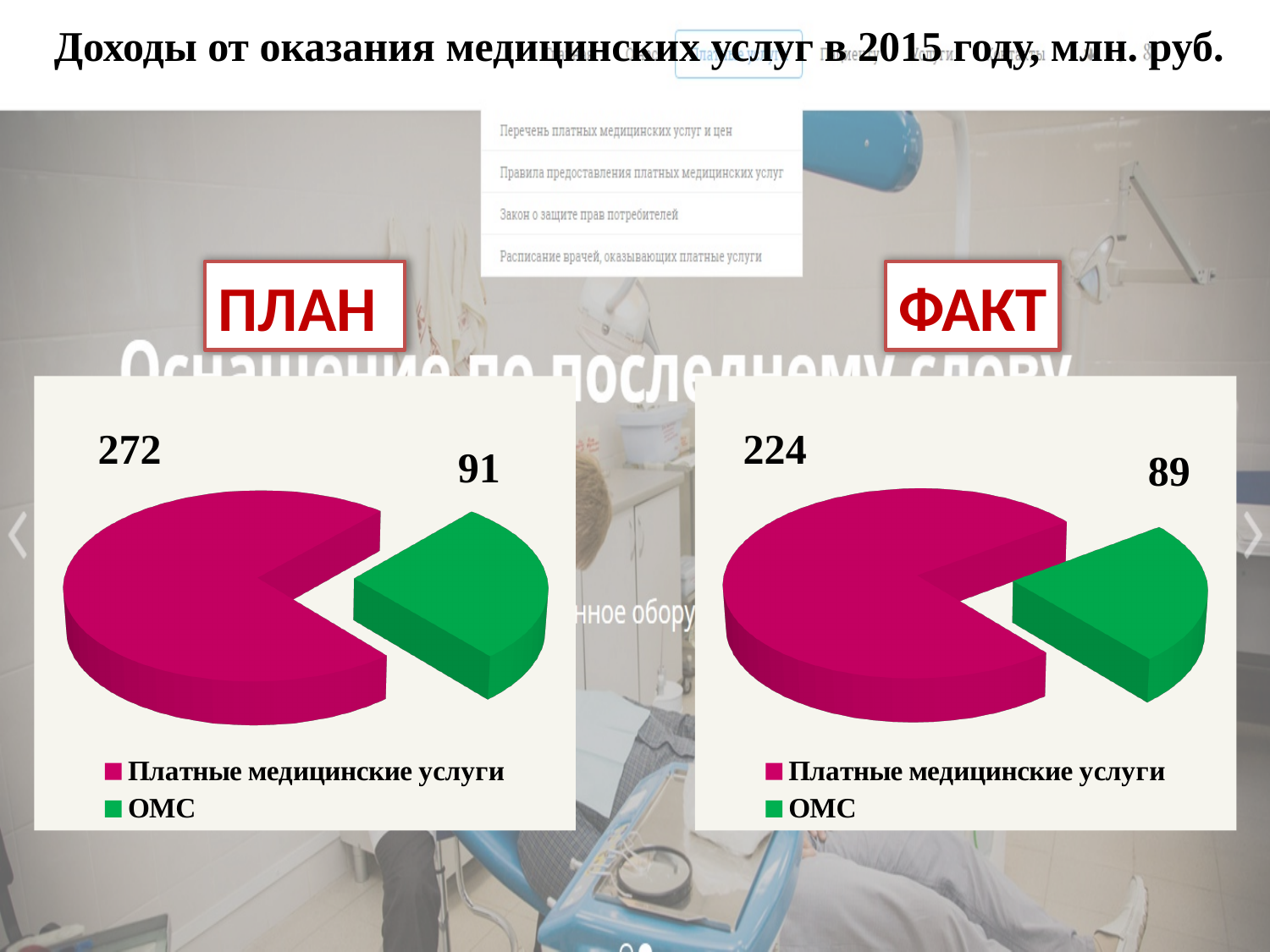
In the ПЛАН pie chart, which category has the largest slice? Платные медицинские услуги Which is larger: Платные медицинские услуги in the ПЛАН chart or in the ФАКТ chart? ПЛАН In the ФАКТ pie chart, which category has the smallest slice? ОМС In the ФАКТ pie chart, what is the value for Платные медицинские услуги? 224 In the ФАКТ pie chart, what is the value for ОМС? 89 In the ПЛАН pie chart, what is the value for ОМС? 91 How many categories does the ФАКТ pie chart show? 2 What type of chart is used on the left (ПЛАН) side of the slide? Pie chart In the ПЛАН pie chart, what is the value for Платные медицинские услуги? 272 In the ПЛАН pie chart, what is the difference between Платные медицинские услуги and ОМС? 181 In the ФАКТ pie chart, what is the difference between Платные медицинские услуги and ОМС? 135 In the ПЛАН pie chart, what colour is the ОМС slice? Green